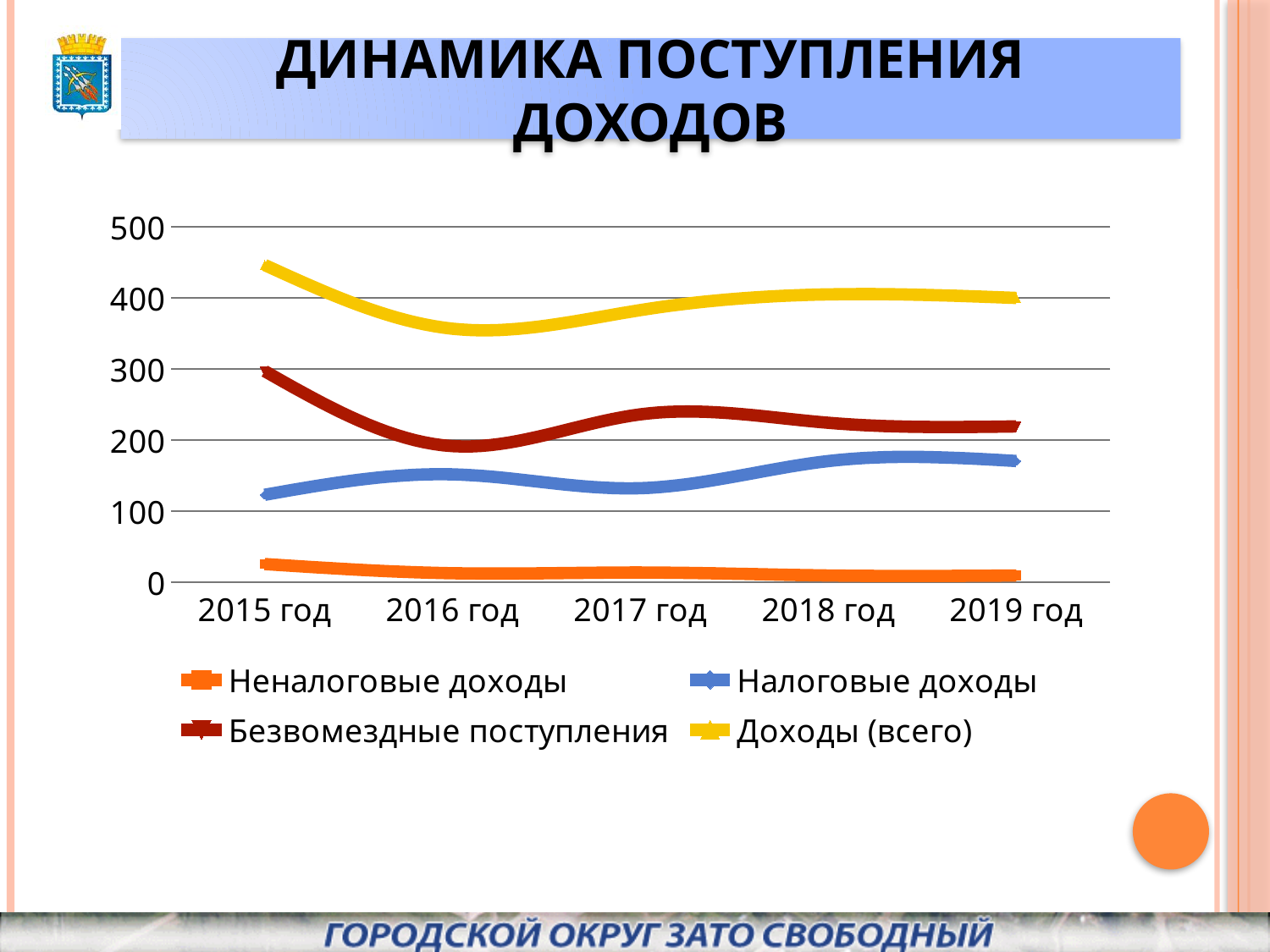
Does the value for Доходы (всего) rise or fall from 2015 год to 2016 год? fall Is the value for Налоговые доходы in 2018 год greater or less than 150? greater In which year is the value for Доходы (всего) highest? 2015 год What is the title of the chart on the slide? ДИНАМИКА ПОСТУПЛЕНИЯ ДОХОДОВ How many series does the legend list? 4 In which year is the value for Доходы (всего) lowest? 2016 год What kind of chart is shown on the slide? line chart Which series has the lowest values across all years? Неналоговые доходы How many years are shown on the x axis? 5 Is the value for Доходы (всего) in 2015 год greater or less than 400? greater In 2015 год, which is larger: Безвозмездные поступления or Налоговые доходы? Безвозмездные поступления Is the value for Неналоговые доходы in 2019 год greater or less than 100? less